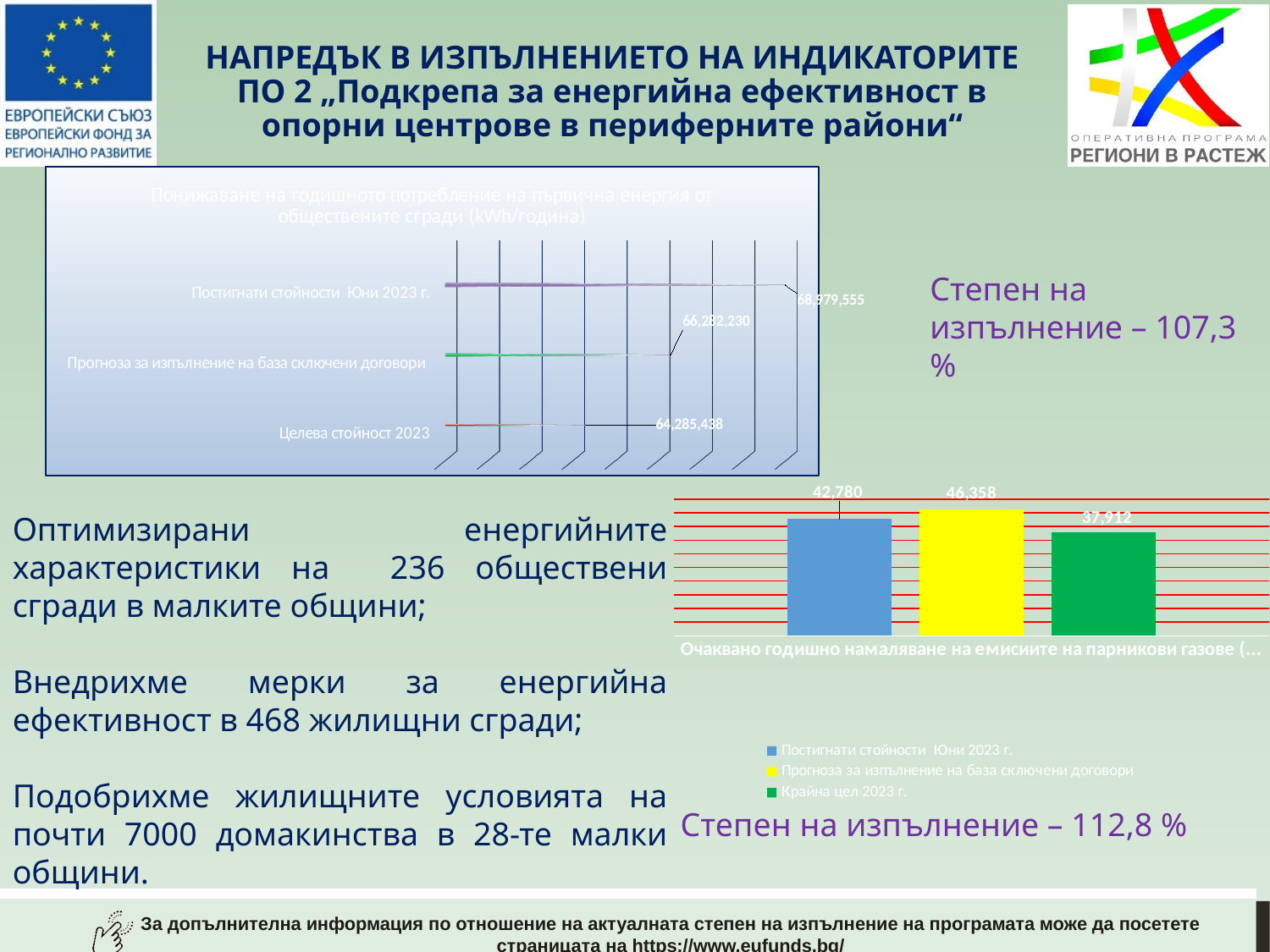
In the bottom chart, what is the value for "Крайна цел 2023 г."? 37,912 In the bottom chart, what is the value of the yellow bar (Прогноза за изпълнение на база сключени договори)? 46,358 In the top chart, what is the difference between "Постигнати стойности Юни 2023 г." and "Целева стойност 2023"? 4,694,117 In the top chart, which category has the lowest value? Целева стойност 2023 In the bottom chart, which series has the highest value? Прогноза за изпълнение на база сключени договори In the top chart, what is the value for "Целева стойност 2023"? 64,285,438 In the top chart, what is the value for "Прогноза за изпълнение на база сключени договори"? 66,282,230 In the bottom chart, what is the difference between "Постигнати стойности Юни 2023 г." and "Крайна цел 2023 г."? 4,868 In the bottom chart, is the value for "Постигнати стойности Юни 2023 г." larger or smaller than the value for "Крайна цел 2023 г."? larger How many entries does the legend of the bottom chart list? 3 What kind of chart is the bottom chart? bar chart In the top chart, what is the value for "Постигнати стойности Юни 2023 г."? 68,979,555